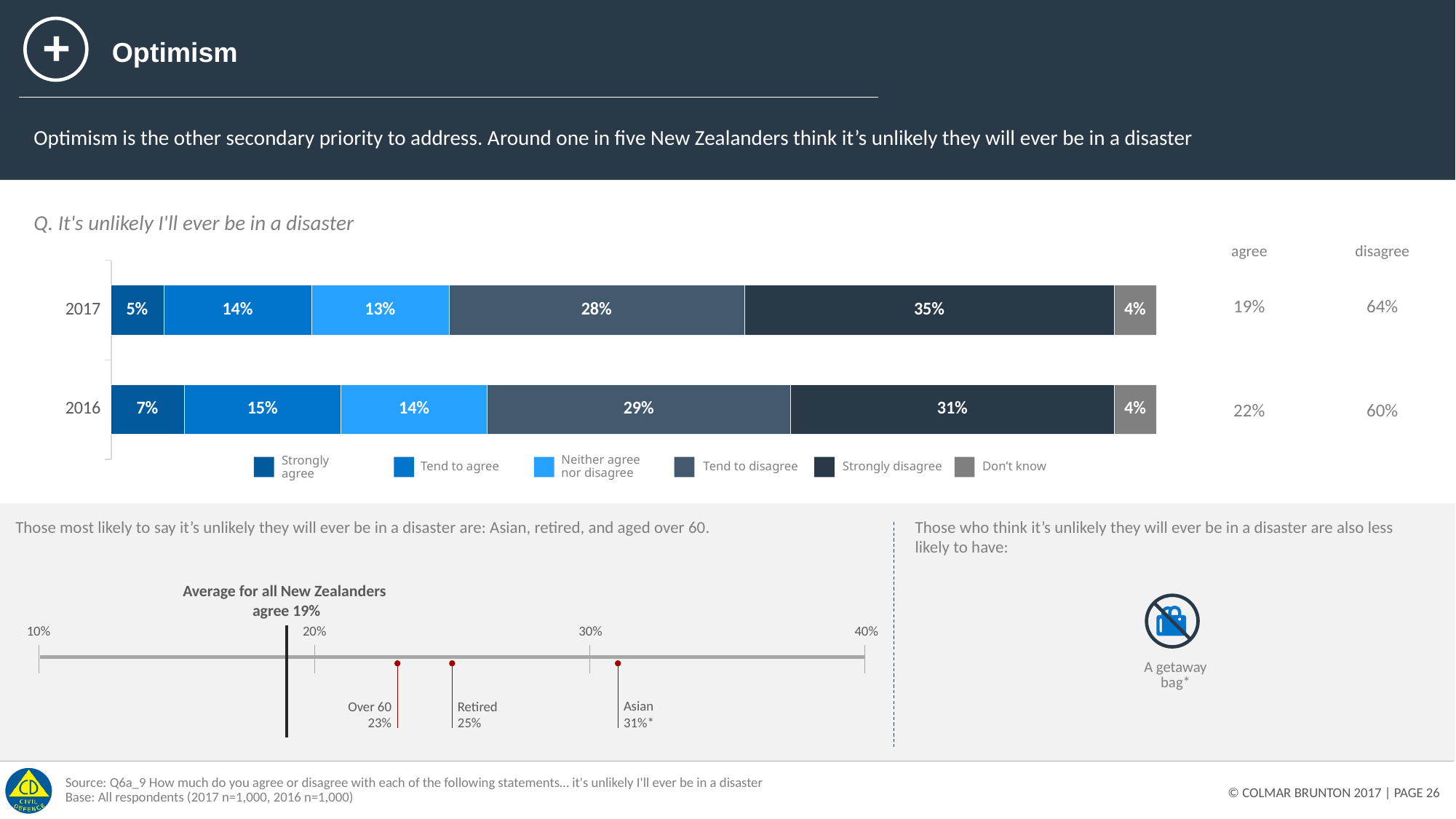
In the stacked bar chart, what percentage of respondents in 2016 said they tend to agree? 15% What type of chart is used to show the 2017 and 2016 responses? Stacked bar chart In the number line chart at the bottom left, what percentage of those aged over 60 agree? 23% In the stacked bar chart, what is the difference in percentage points between the 'Tend to disagree' values for 2016 and 2017? 1 percentage point In the number line chart at the bottom left, what is the average agreement for all New Zealanders marked by the vertical line? 19% How many response categories does the legend of the stacked bar chart list? 6 In the stacked bar chart, what percentage of respondents in 2017 strongly disagreed that it's unlikely they'll ever be in a disaster? 35% How many years are shown as bars in the stacked bar chart? 2 According to the summary column next to the stacked bar chart, what was the total 'agree' percentage in 2016? 22% In the number line chart at the bottom left, which group has the highest agreement percentage? Asian In the stacked bar chart, what is the 'Don't know' percentage for 2017? 4% In the stacked bar chart, which year has the larger 'Strongly disagree' share, 2017 or 2016? 2017